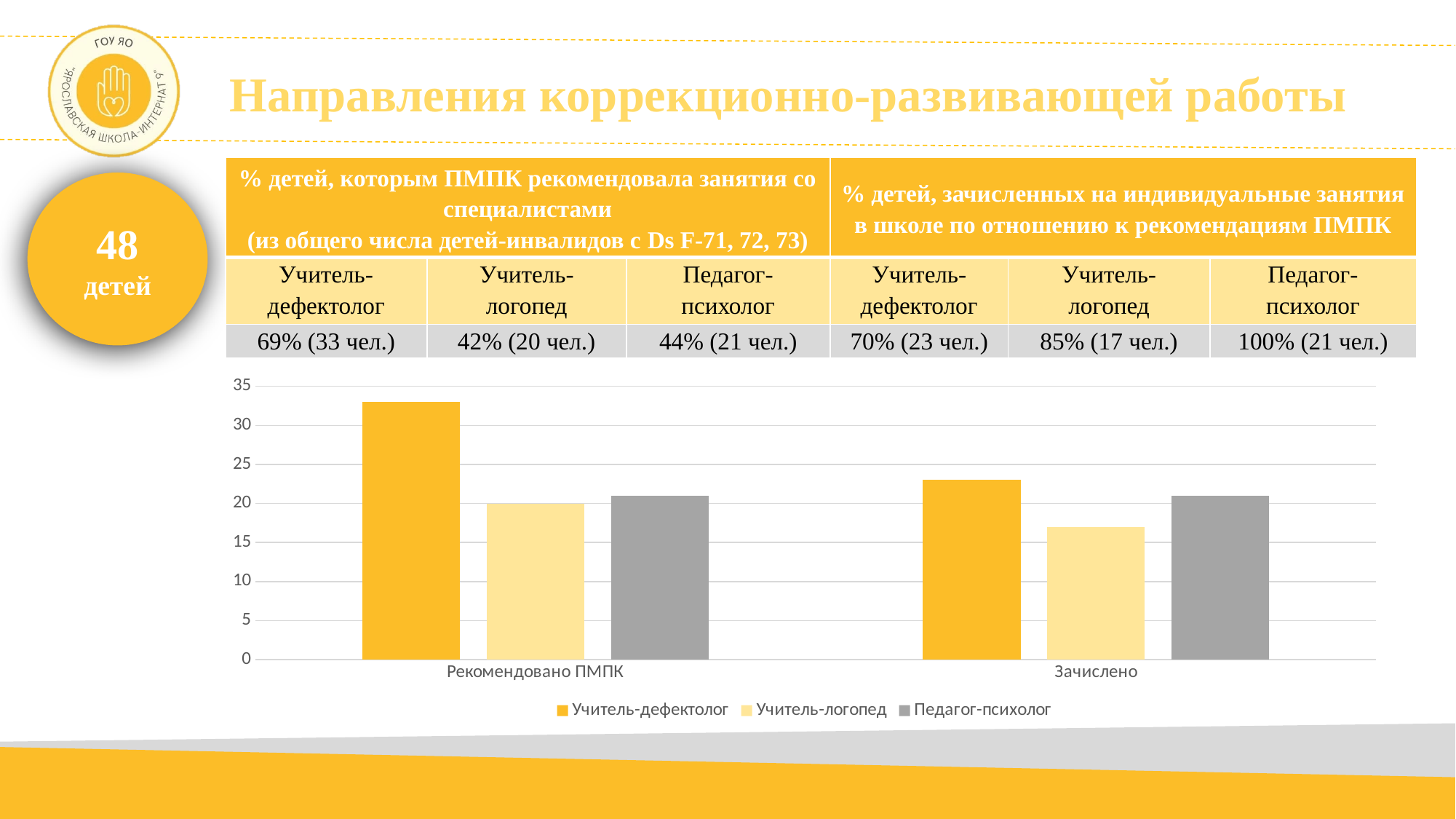
Is the value for Педагог-психолог in the Рекомендовано ПМПК category greater or less than 20? greater How many categories are shown on the x axis of the chart? 2 Which is larger: the Учитель-дефектолог bar for Рекомендовано ПМПК or the Учитель-дефектолог bar for Зачислено? Рекомендовано ПМПК Does the Учитель-логопед value rise or fall from Рекомендовано ПМПК to Зачислено? fall What colour are the Педагог-психолог bars in the chart? grey How many series does the chart legend list? 3 Is the value for Учитель-дефектолог in the Рекомендовано ПМПК category greater or less than 30? greater What kind of chart is shown on the slide? bar chart Is the value for Учитель-логопед in the Зачислено category greater or less than 20? less What is the highest tick value shown on the chart's vertical axis? 35 Which series has the tallest bar in the Рекомендовано ПМПК category? Учитель-дефектолог Which series has the shortest bar in the Зачислено category? Учитель-логопед